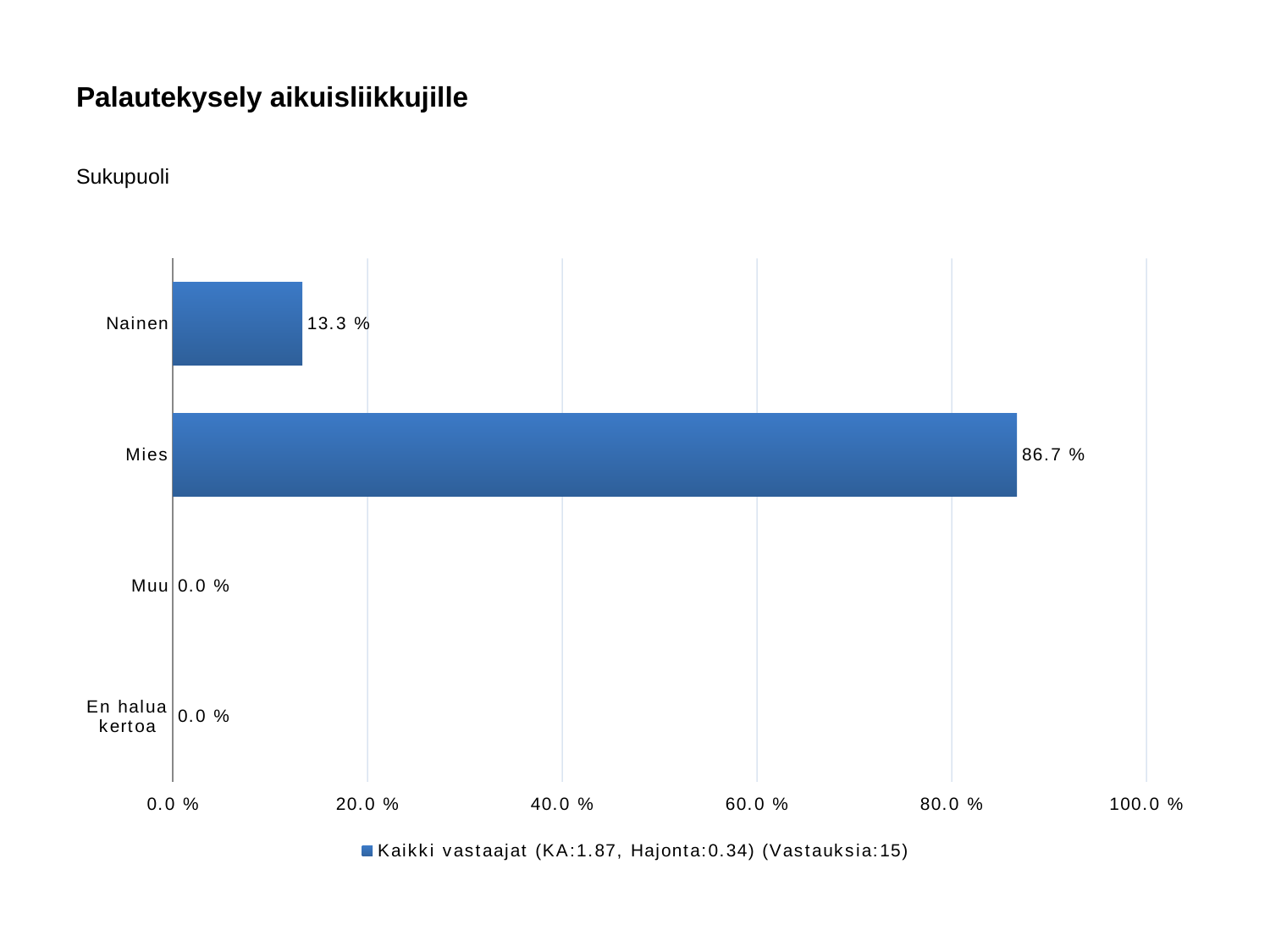
What is the value for Muu? 0.0 % How many categories are shown on the chart? 4 Which category has the highest value? Mies How many series does the legend list? 1 Is the value for Mies greater or less than 80.0 %? greater What is the subtitle of the chart shown below the main title? Sukupuoli What is the value for Mies? 86.7 % Which is larger, the value for Nainen or the value for Mies? Mies What is the value for En halua kertoa? 0.0 % What is the value for Nainen? 13.3 % What kind of chart is shown on the slide? bar chart What is the difference between the values for Mies and Nainen? 73.4 %